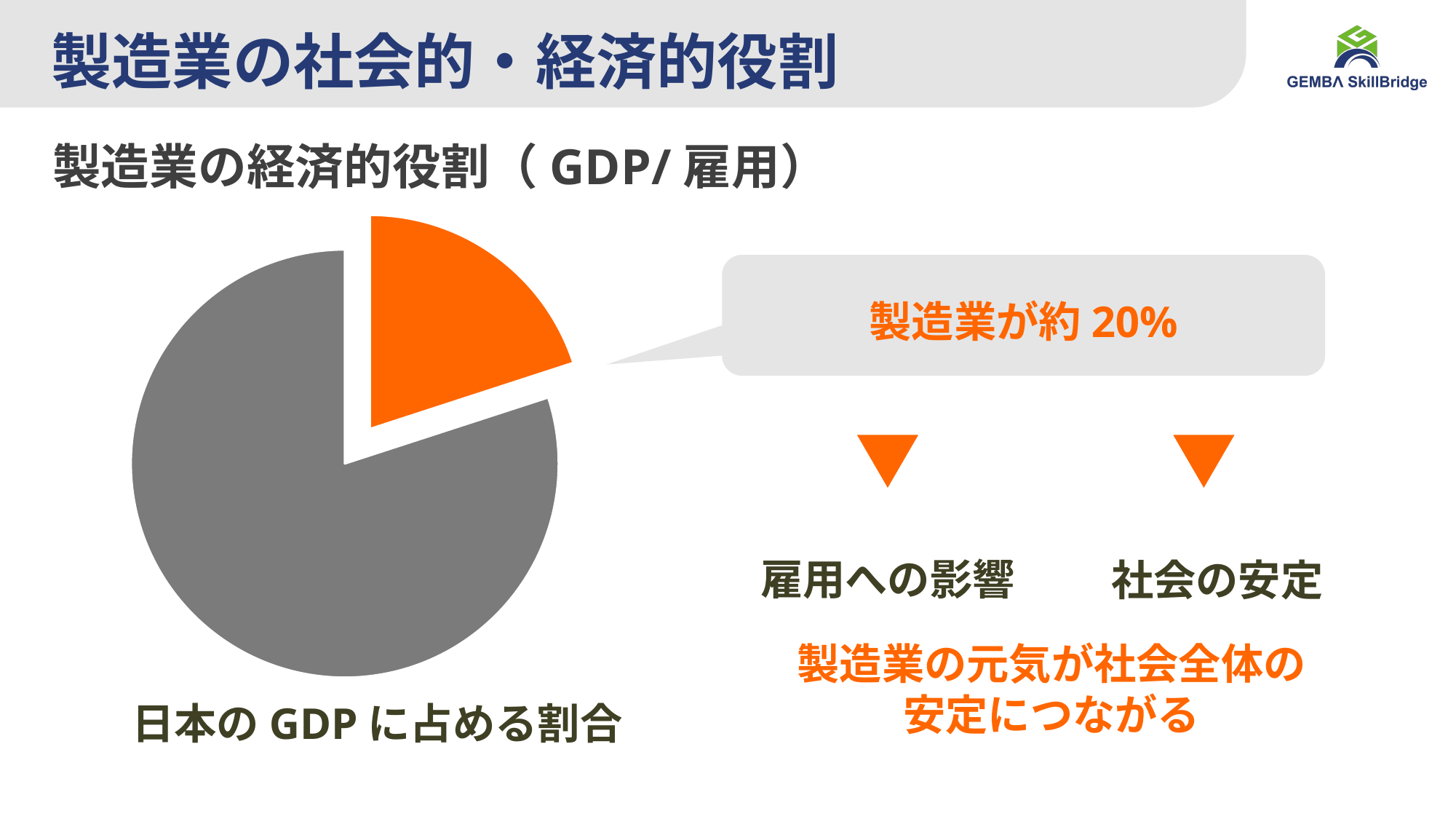
Is the manufacturing (製造業) slice of the pie chart greater or less than half of the pie? less According to the callout on the pie chart, what share of Japan's GDP does manufacturing (製造業) account for? 約 20% What is the caption printed below the pie chart? 日本の GDP に占める割合 Is the manufacturing (製造業) slice of the pie chart larger or smaller than the remaining slice? smaller What colour is the manufacturing (製造業) slice in the pie chart? orange How many slices does the pie chart have? 2 What kind of chart is shown on the slide? pie chart